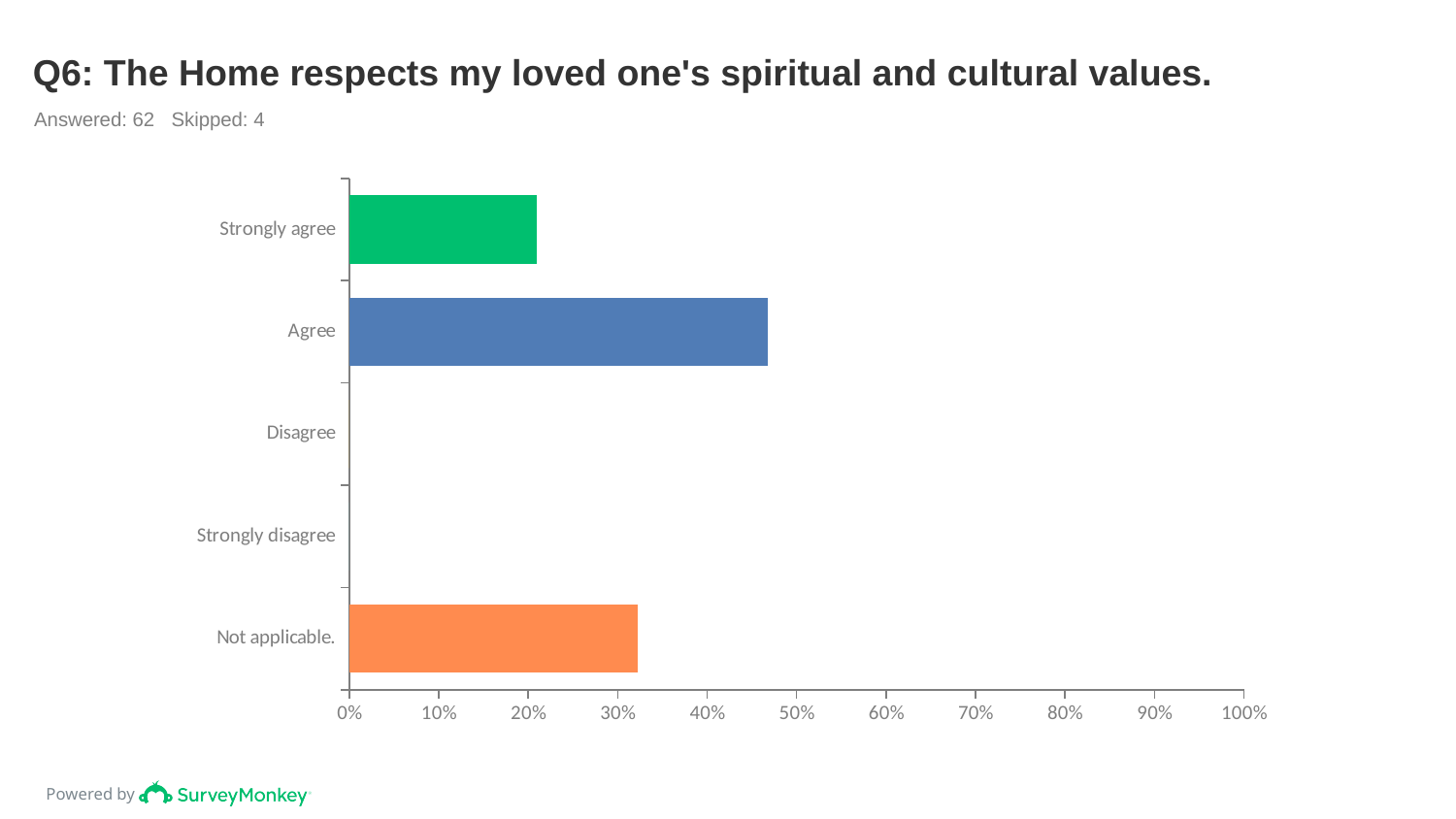
Is the value for Not applicable greater or less than 30%? greater Is the value for Agree greater or less than 50%? less What is the title of the chart? Q6: The Home respects my loved one's spiritual and cultural values. Which is larger, the value for Strongly agree or the value for Not applicable? Not applicable Is the value for Agree greater or less than 40%? greater Which is larger, the value for Agree or the value for Not applicable? Agree How many respondents answered this question, and how many skipped it? Answered: 62, Skipped: 4 Which response categories show no bar at all? Disagree and Strongly disagree What kind of chart is shown on the slide? Bar chart How many response categories are listed on the chart? 5 Which response category has the highest value? Agree